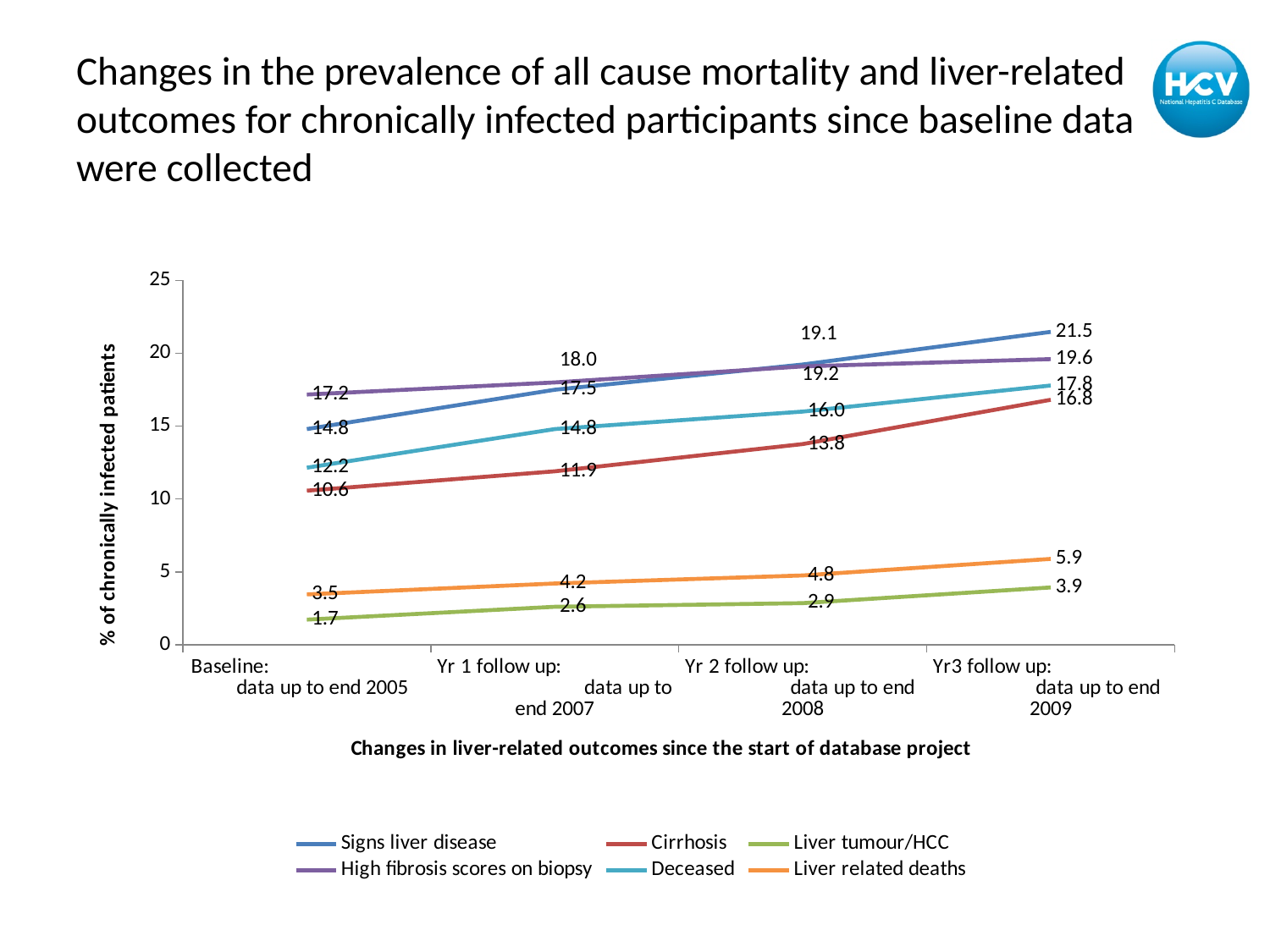
Does the Cirrhosis line rise or fall from Baseline to Yr3 follow up? rise What is the value for Cirrhosis at Baseline (data up to end 2005)? 10.6 What is the value for Signs liver disease at Yr3 follow up (data up to end 2009)? 21.5 What is the value for Liver tumour/HCC at Yr 2 follow up (data up to end 2008)? 2.9 At Yr 1 follow up, which is larger: Liver related deaths or Liver tumour/HCC? Liver related deaths How many series does the legend list? 6 By how much did the Deceased value increase from Baseline to Yr3 follow up? 5.6 What is the value for Liver related deaths at Yr3 follow up (data up to end 2009)? 5.9 Which series has the lowest value at Baseline (data up to end 2005)? Liver tumour/HCC Which series has the highest value at Yr3 follow up (data up to end 2009)? Signs liver disease What kind of chart is shown on the slide? line chart How many time points are plotted along the x axis? 4